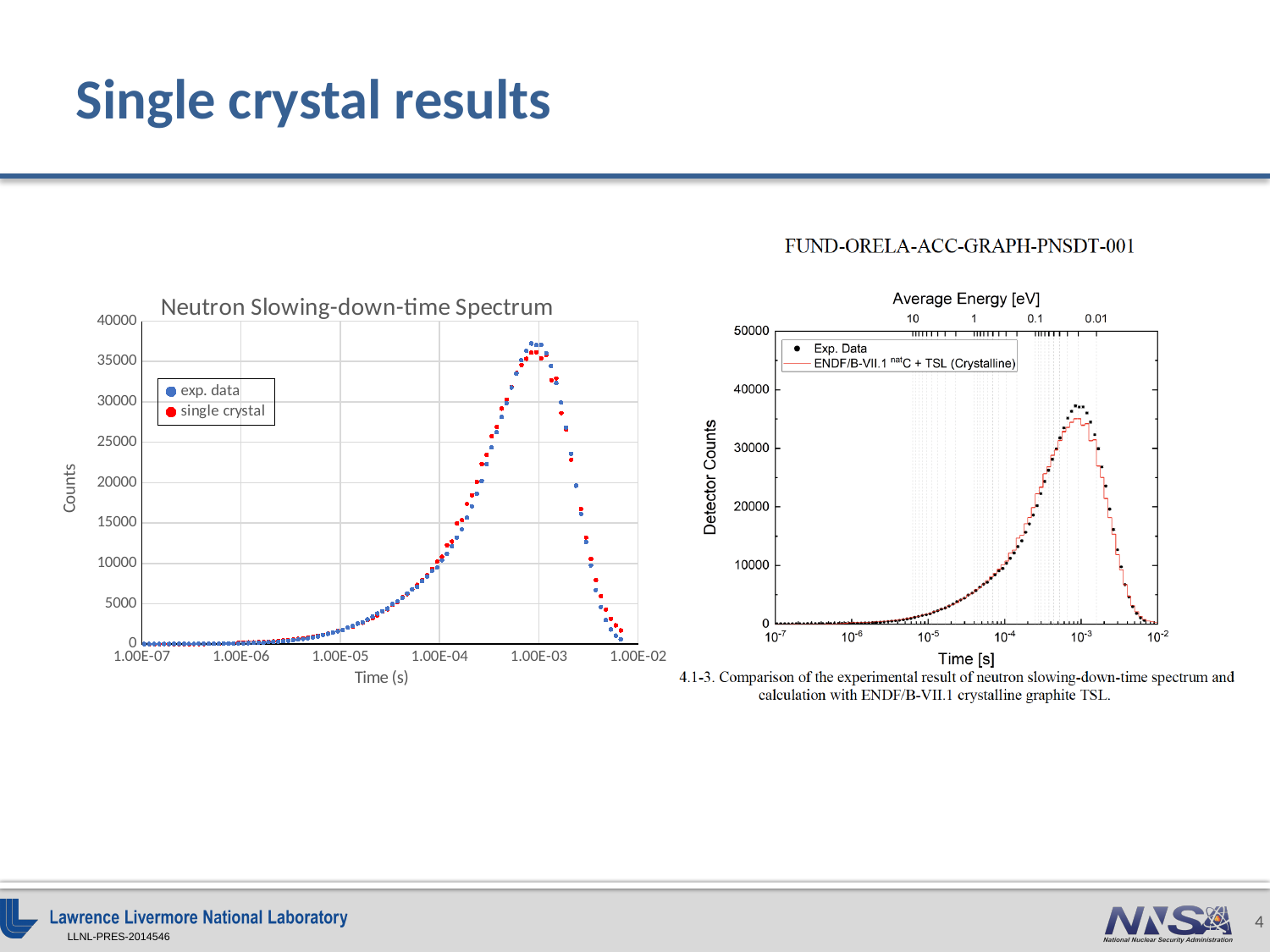
In the Neutron Slowing-down-time Spectrum chart, do the counts rise or fall as time increases from 1.00E-03 s to 1.00E-02 s? fall What kind of chart is the Neutron Slowing-down-time Spectrum chart? scatter chart What is the title of the chart on the left side of the slide? Neutron Slowing-down-time Spectrum In the FUND-ORELA-ACC-GRAPH-PNSDT-001 chart on the right, is the Exp. Data value at 10^-5 s greater or less than 10000? less In the Neutron Slowing-down-time Spectrum chart, is the value of the exp. data series at 1.00E-05 s greater or less than 5000? less In the FUND-ORELA-ACC-GRAPH-PNSDT-001 chart on the right, is the peak of the ENDF/B-VII.1 natC + TSL (Crystalline) line greater or less than 40000? less In the Neutron Slowing-down-time Spectrum chart, what are the two series named in the legend? exp. data and single crystal In the FUND-ORELA-ACC-GRAPH-PNSDT-001 chart on the right, how many series does the legend list? 2 In the Neutron Slowing-down-time Spectrum chart, how many series does the legend list? 2 In the Neutron Slowing-down-time Spectrum chart, do the counts rise or fall as time increases from 1.00E-07 s to 1.00E-03 s? rise